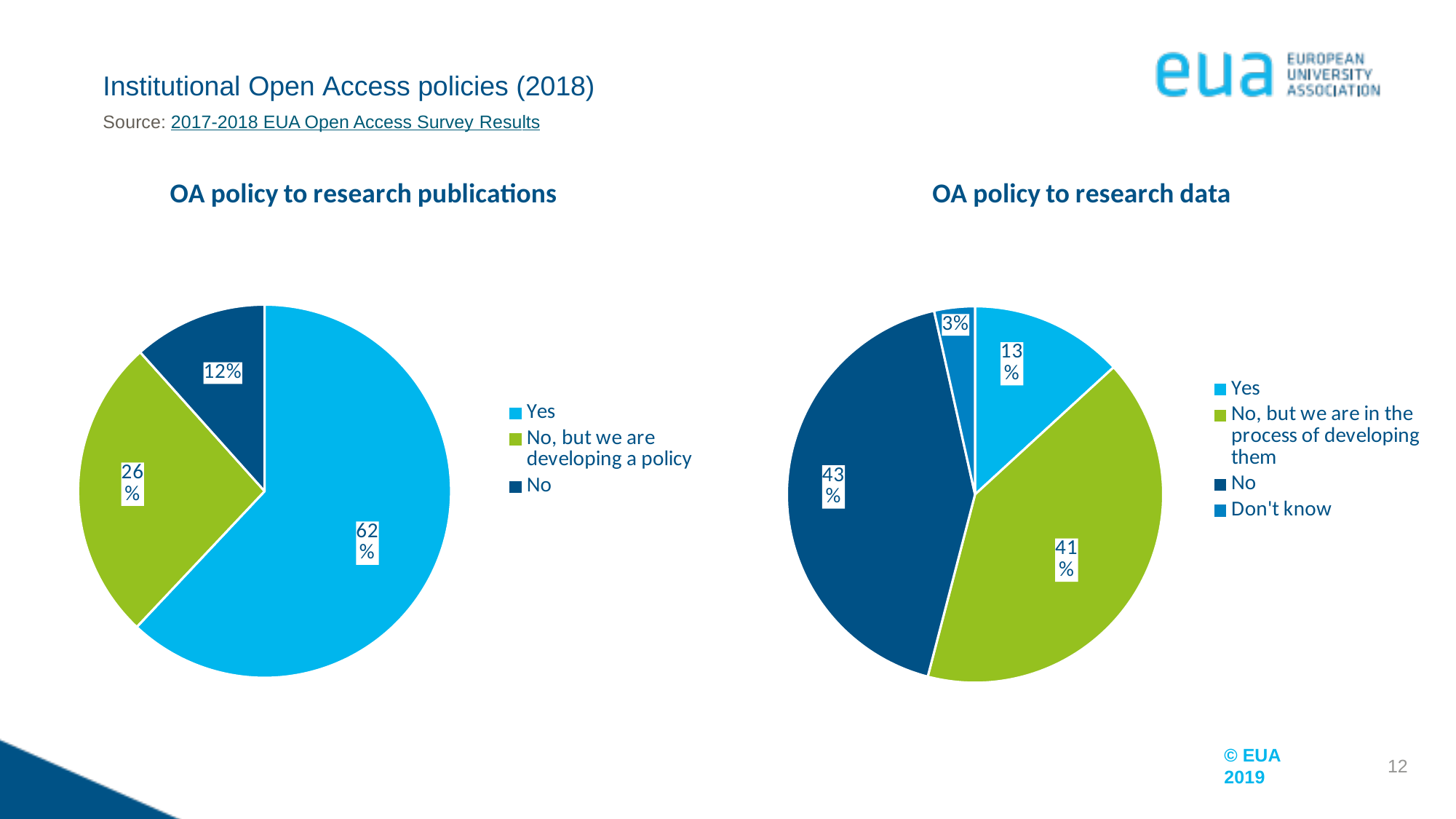
In the 'OA policy to research data' chart, which category has the largest slice? No In the 'OA policy to research data' chart, what share answered 'No'? 43% In the 'OA policy to research publications' chart, what is the difference between the 'Yes' and 'No' shares? 50% How many slices does the 'OA policy to research publications' pie chart have? 3 What type of chart is used for 'OA policy to research publications'? Pie chart In the 'OA policy to research publications' chart, what share answered 'No, but we are developing a policy'? 26% In the 'OA policy to research data' chart, what is the difference between the 'No' and 'Yes' shares? 30% In the 'OA policy to research publications' chart, what share of respondents answered 'Yes'? 62% In the 'OA policy to research publications' chart, which category has the smallest slice? No How many categories does the legend of the 'OA policy to research data' chart list? 4 In the 'OA policy to research data' chart, which is larger: 'Yes' or 'No, but we are in the process of developing them'? No, but we are in the process of developing them In the 'OA policy to research data' chart, what share answered 'Don't know'? 3%